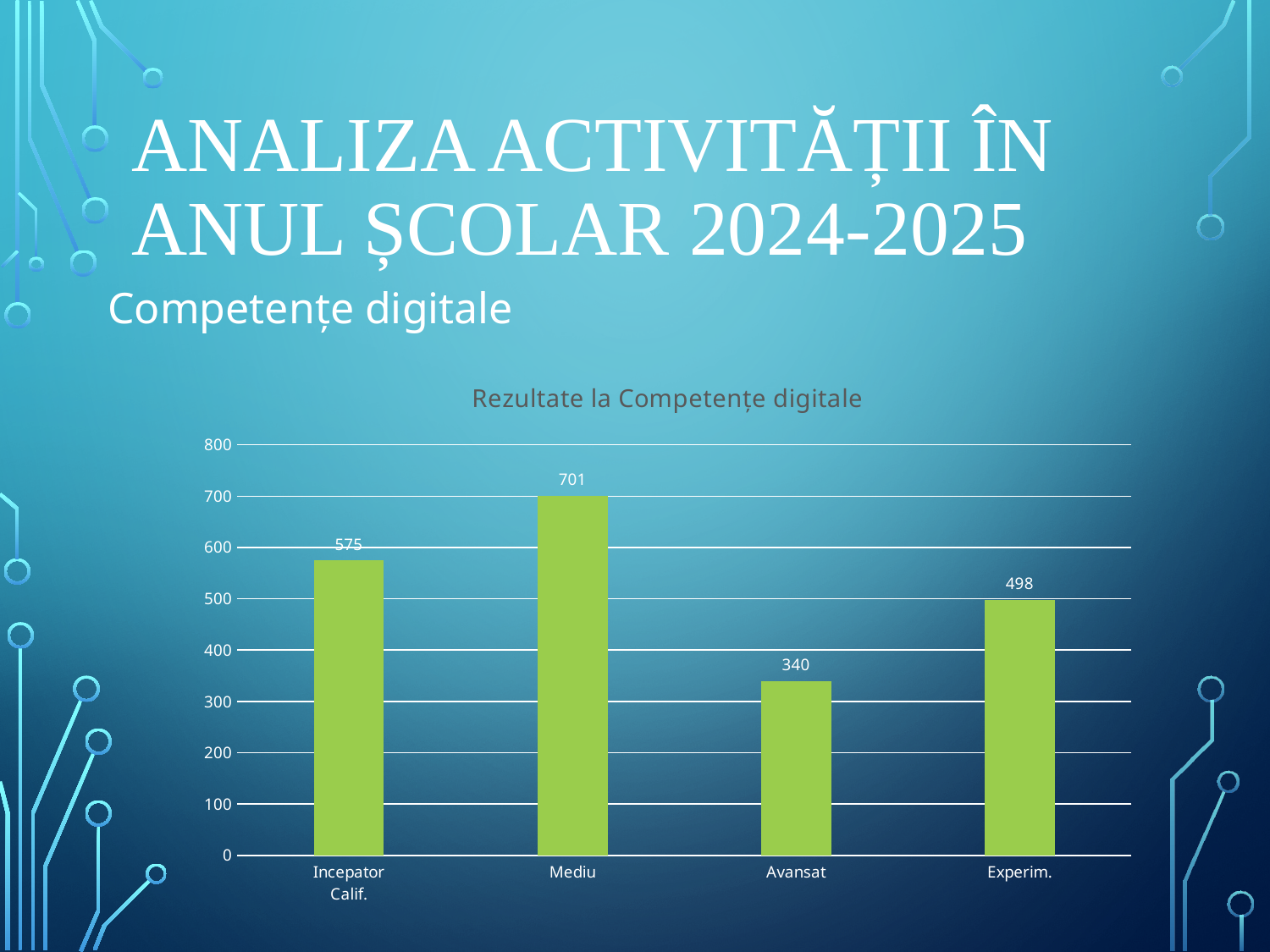
What is the title of the chart? Rezultate la Competențe digitale What is the value for Mediu? 701 What is the difference between the values for Incepator Calif. and Experim.? 77 What is the value for Experim.? 498 Which category has the lowest value? Avansat What is the difference between the values for Mediu and Avansat? 361 What is the value for Incepator Calif.? 575 What is the value for Avansat? 340 Which category has the highest value? Mediu Which is larger, the value for Incepator Calif. or the value for Experim.? Incepator Calif. How many categories are shown on the x axis? 4 What kind of chart is shown on the slide? Bar chart